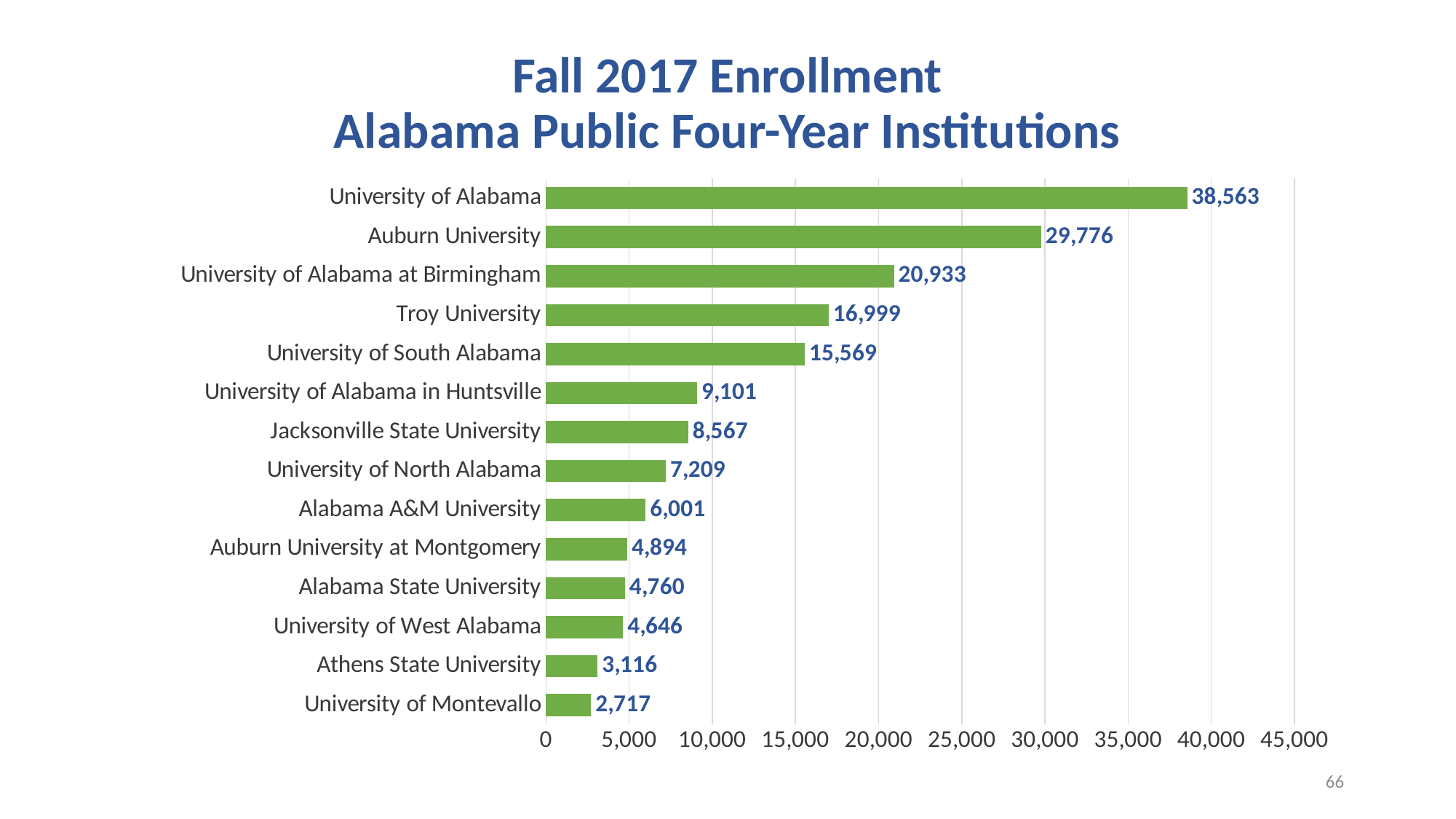
What is the Fall 2017 enrollment for University of Montevallo? 2,717 What is the Fall 2017 enrollment for Jacksonville State University? 8,567 Which institution has the highest Fall 2017 enrollment? University of Alabama What is the difference in enrollment between University of Alabama and Auburn University? 8,787 Which has a larger enrollment, University of Alabama in Huntsville or University of North Alabama? University of Alabama in Huntsville What is the difference in enrollment between University of Alabama at Birmingham and University of South Alabama? 5,364 How many institutions are shown in the chart? 14 Is the enrollment for Auburn University greater or less than 25,000? greater What is the Fall 2017 enrollment for Troy University? 16,999 Which institution has the lowest Fall 2017 enrollment? University of Montevallo What type of chart is shown on the slide? Bar chart What is the title of the chart? Fall 2017 Enrollment Alabama Public Four-Year Institutions